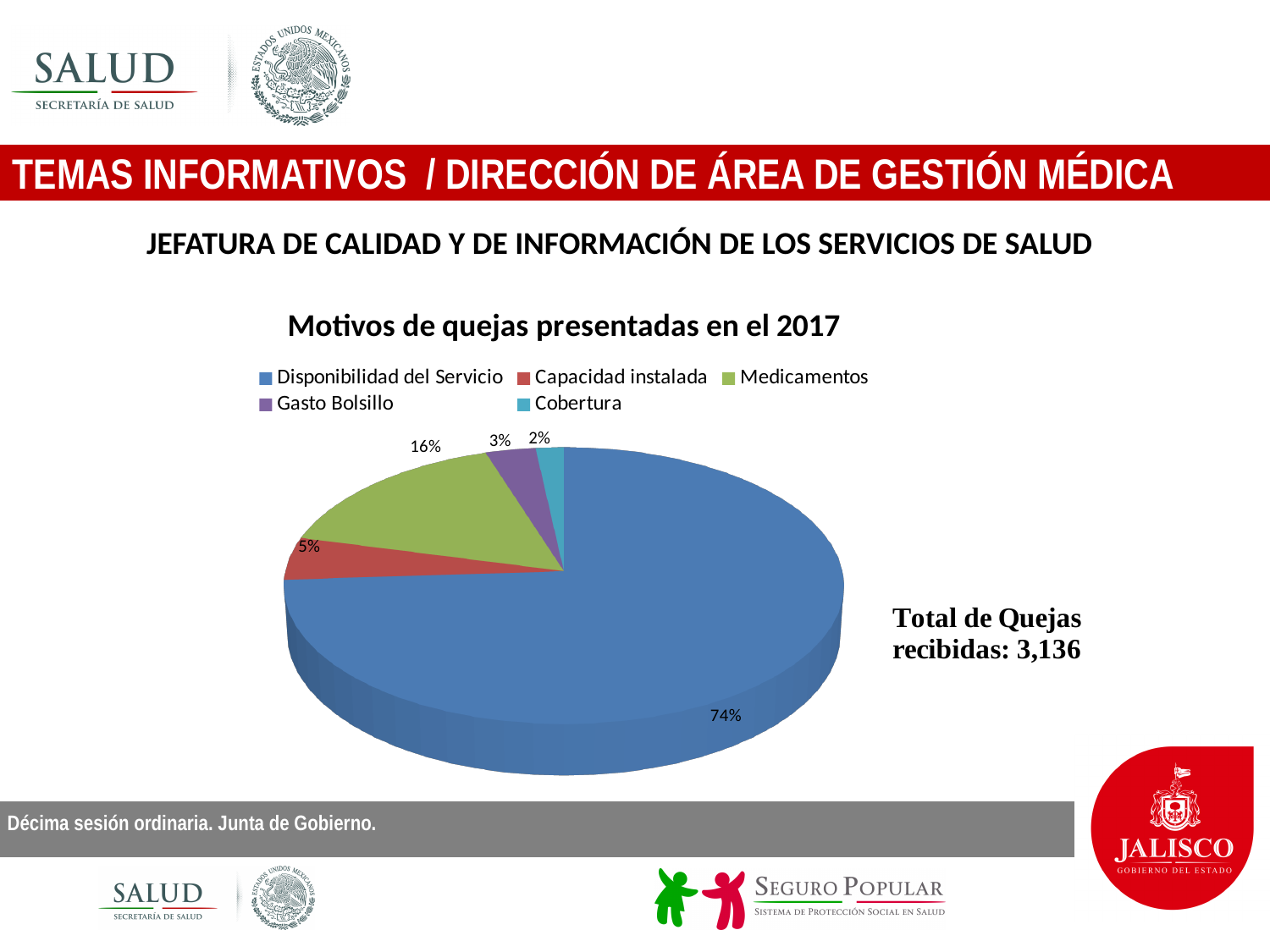
What kind of chart is shown on the slide? Pie chart Which category has the smallest slice of the pie? Cobertura Which category has the largest slice of the pie? Disponibilidad del Servicio What share of the pie does Gasto Bolsillo represent? 3% What share of the pie does Cobertura represent? 2% What share of the pie does Medicamentos represent? 16% How many categories does the legend of the pie chart list? 5 What is the title of the chart? Motivos de quejas presentadas en el 2017 Which is larger, the share for Medicamentos or the share for Capacidad instalada? Medicamentos What is the difference in percentage points between the Disponibilidad del Servicio slice and the Medicamentos slice? 58 percentage points